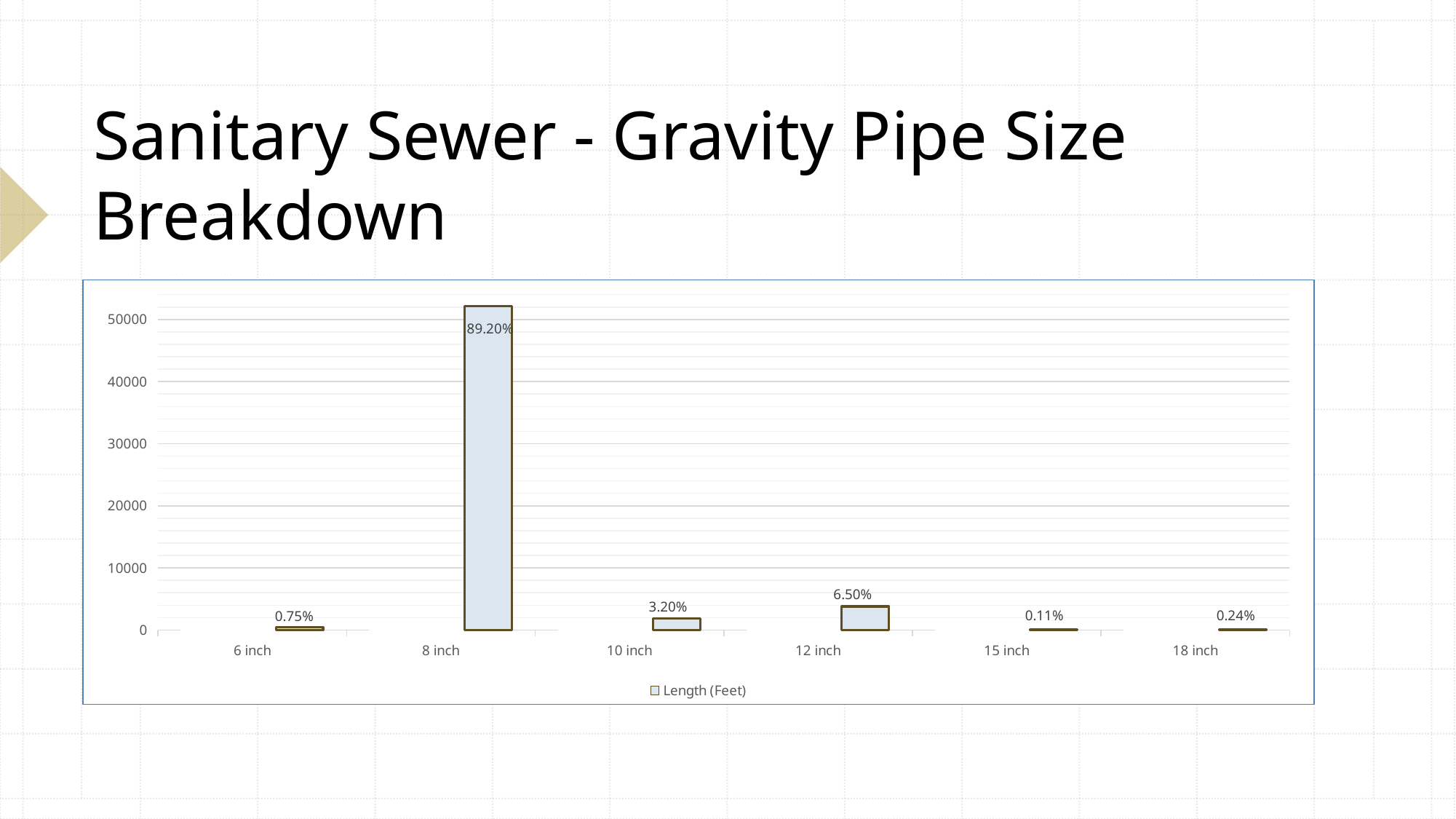
Which pipe size has the highest value? 8 inch Is the value for 8 inch greater or less than 40000? greater How many pipe size categories are shown on the x axis? 6 What percentage label is shown on the bar for 8 inch? 89.20% How many series does the legend list? 1 Which has a larger value, 10 inch or 12 inch? 12 inch What is the difference between the percentage labels for 8 inch and 12 inch? 82.70% What percentage label is shown on the bar for 15 inch? 0.11% What kind of chart is shown on the slide? bar chart What percentage label is shown on the bar for 12 inch? 6.50% What is the legend entry for the series? Length (Feet) Which pipe size has the lowest value? 15 inch